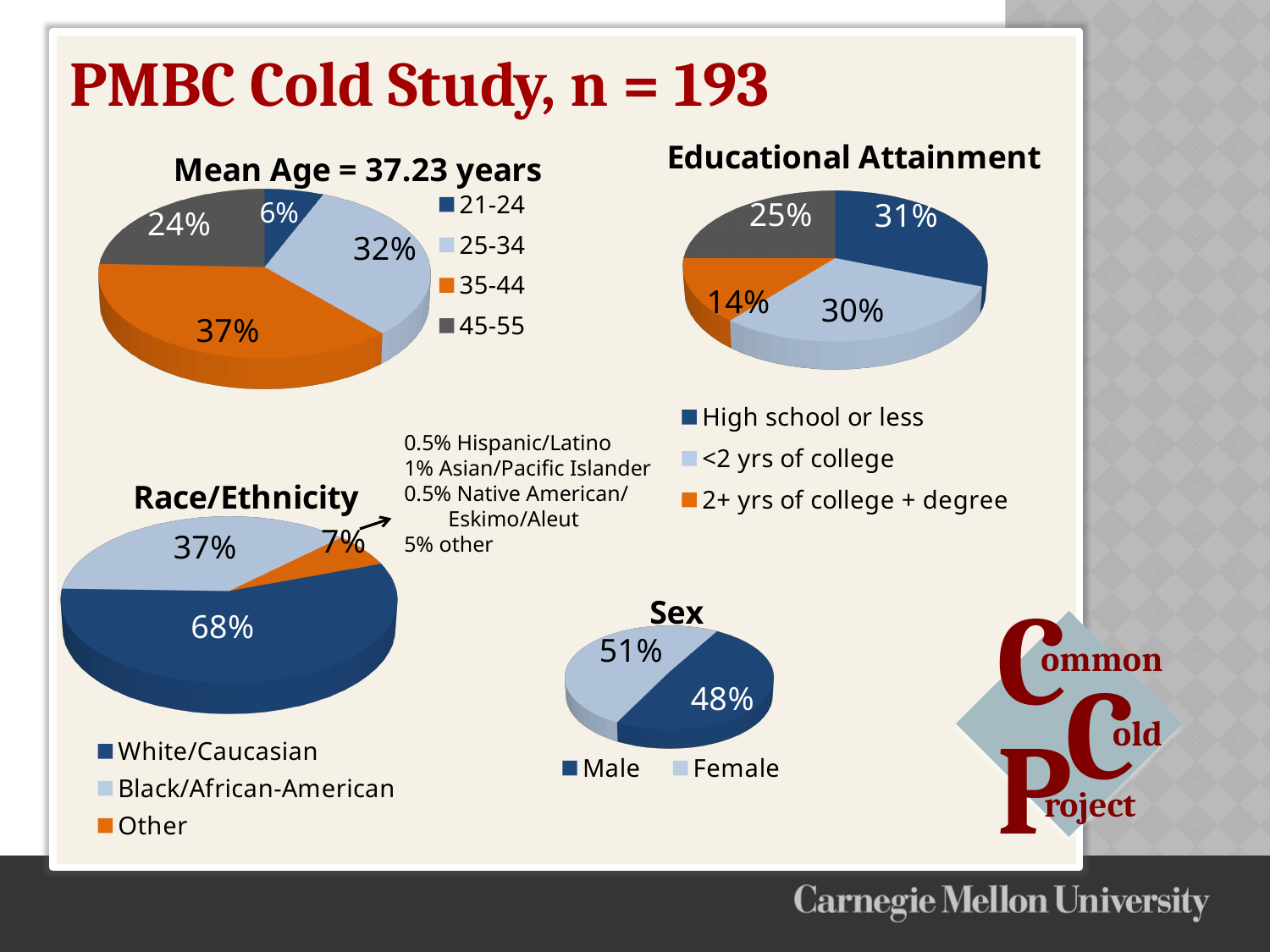
In the Educational Attainment pie chart, which is larger: the share for high school or less or the share for <2 yrs of college? High school or less In the Sex pie chart, which is larger: the Male share or the Female share? Female In the Race/Ethnicity pie chart, what percentage of participants are White/Caucasian? 68% In the Educational Attainment pie chart, what percentage of participants have high school or less? 31% How many age groups does the legend of the Mean Age pie chart list? 4 In the Mean Age pie chart, what is the difference between the 25-34 share and the 45-55 share? 8% In the Race/Ethnicity pie chart, which category has the largest share? White/Caucasian In the Educational Attainment pie chart, what percentage of participants have 2+ yrs of college + degree? 14% What kind of chart is the Sex chart? Pie chart In the Mean Age pie chart, what percentage of participants are aged 35-44? 37% In the Mean Age pie chart, which age group has the smallest share? 21-24 In the Sex pie chart, what percentage of participants are Male? 48%